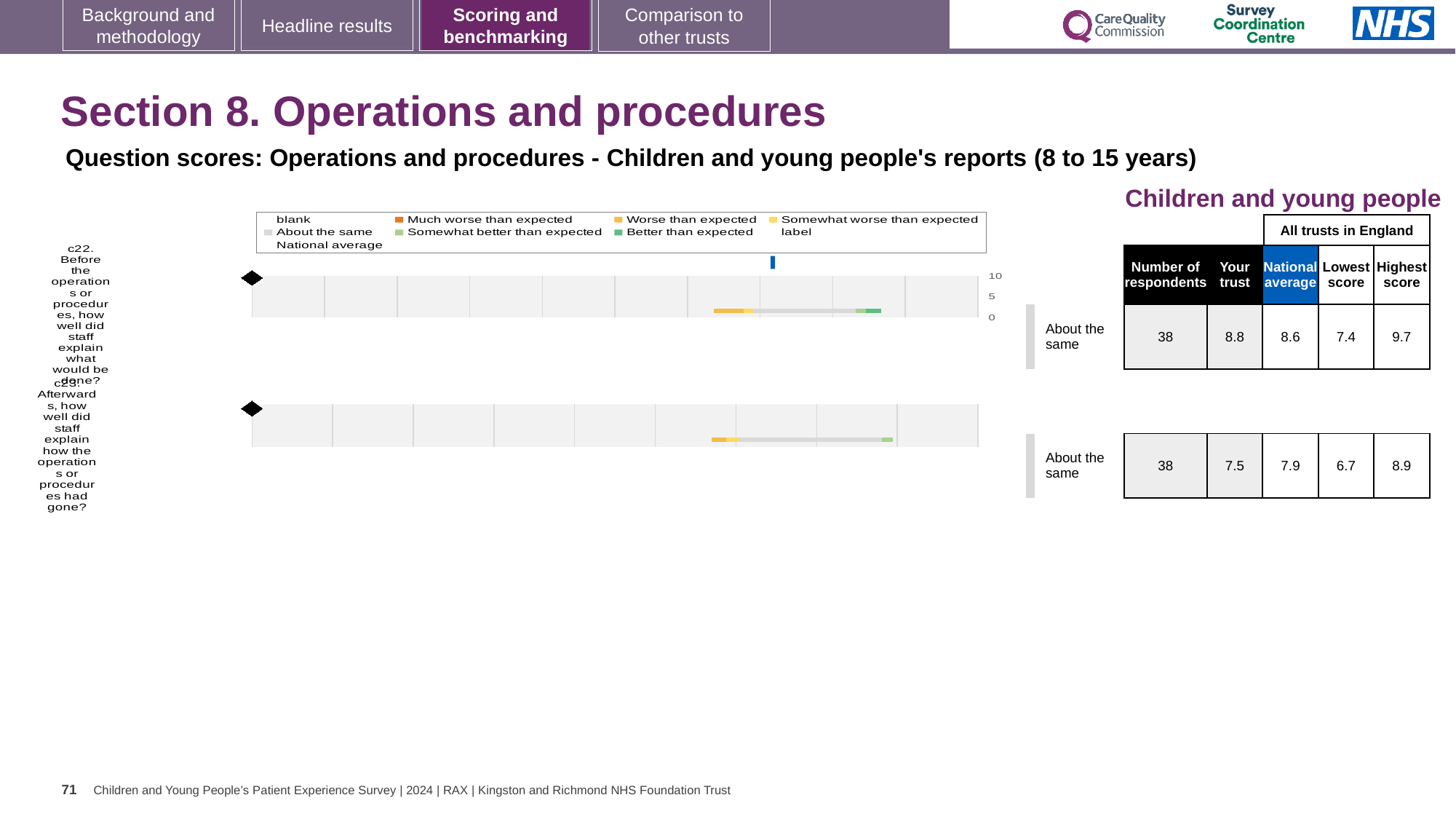
How many questions (c22 and c23) are plotted as separate bars on the slide? 2 What kind of chart is used to show the question scores for c22 and c23? bar chart For the c22 chart (Before the operations or procedures, how well did staff explain what would be done?), what is the 'Your trust' score? 8.8 For the c23 chart, what is the national average score? 7.9 How many respondents are shown for the c22 chart? 38 For the c23 chart, what is the difference between the highest score (8.9) and the lowest score (6.7) across all trusts in England? 2.2 For the c22 chart, which is larger: the 'Your trust' score or the national average? Your trust Which question, c22 or c23, has the higher 'Your trust' score? c22 For the c23 chart (Afterwards, how well did staff explain how the operations or procedures had gone?), what is the 'Your trust' score? 7.5 For the c22 chart, what is the difference between the highest score (9.7) and the lowest score (7.4) across all trusts in England? 2.3 For the c22 chart, what is the national average score? 8.6 What benchmark category label is shown next to both the c22 and c23 charts? About the same